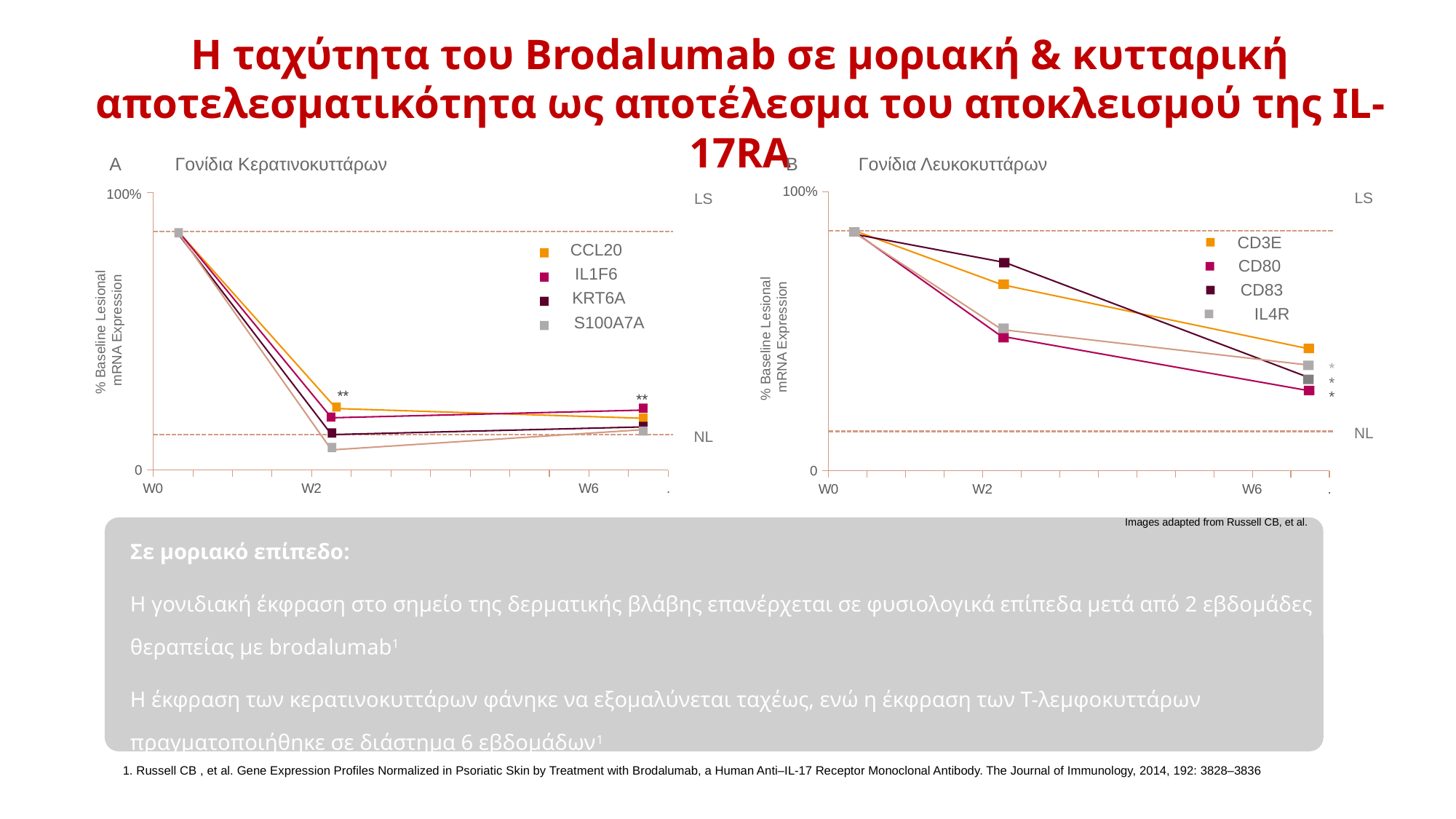
Which series are listed in the legend of chart B (Γονίδια Λευκοκυττάρων)? CD3E, CD80, CD83, IL4R In chart B (Γονίδια Λευκοκυττάρων), do the values rise or fall from W0 to W6? Fall In chart A (Γονίδια Κερατινοκυττάρων), do the values rise or fall from W0 to W2? Fall How many series does the legend of chart A (Γονίδια Κερατινοκυττάρων) list? 4 In chart B (Γονίδια Λευκοκυττάρων), which is larger at W2: CD83 or CD80? CD83 What is the label of the y axis in chart A (Γονίδια Κερατινοκυττάρων)? % Baseline Lesional mRNA Expression In chart B (Γονίδια Λευκοκυττάρων), which series has the highest value at W2? CD83 In chart A (Γονίδια Κερατινοκυττάρων), which series has the lowest value at W2? S100A7A What kind of chart is chart A (Γονίδια Κερατινοκυττάρων)? Line chart In chart B (Γονίδια Λευκοκυττάρων), which series has the highest value at W6? CD3E How many series does the legend of chart B (Γονίδια Λευκοκυττάρων) list? 4 How many time points are shown on the x axis of chart A (Γονίδια Κερατινοκυττάρων)? 3